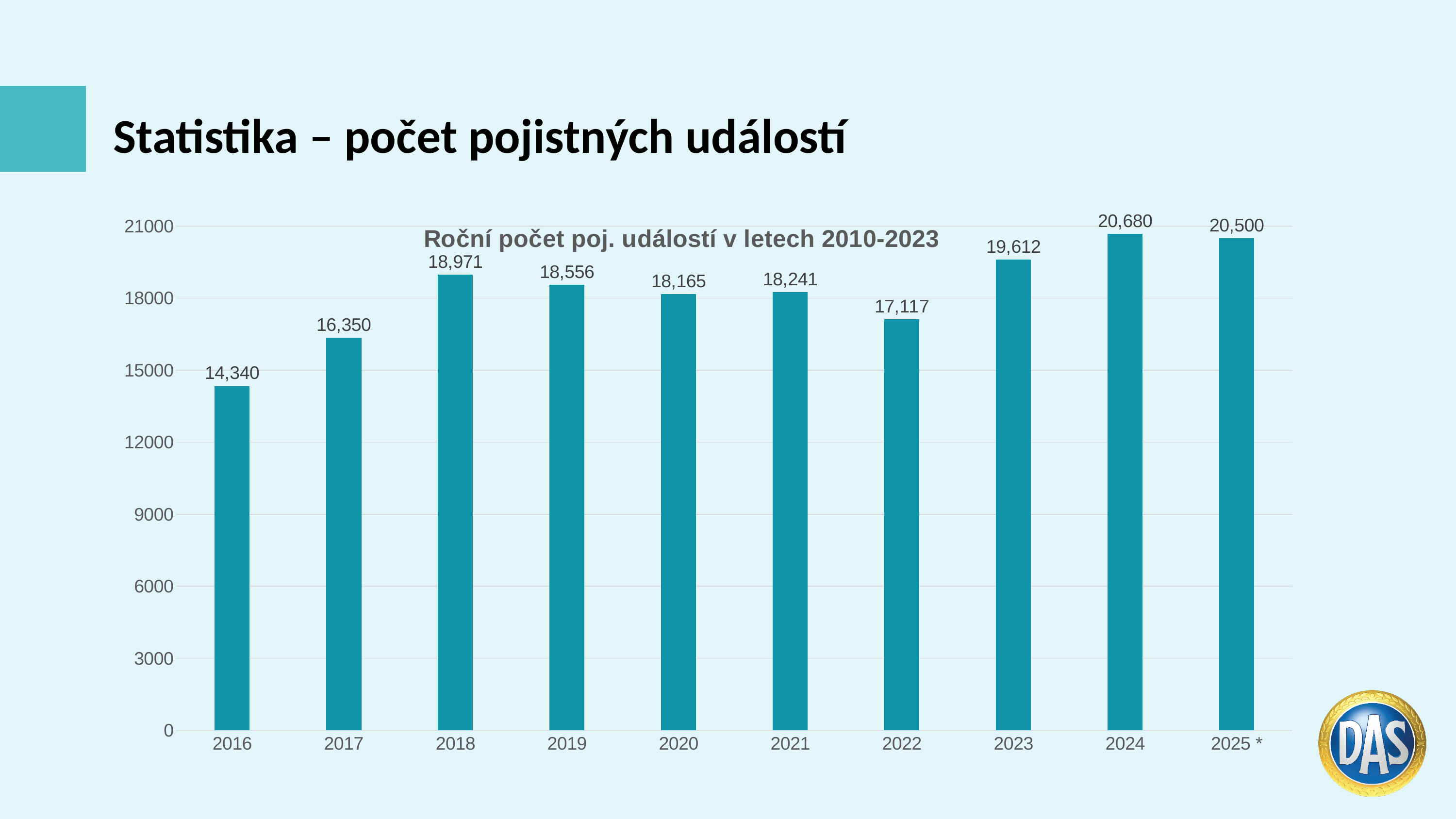
What is the difference between the values for 2024 and 2023? 1,068 What is the title of the chart? Roční počet poj. událostí v letech 2010-2023 What kind of chart is shown? bar chart Is the value for 2017 greater or less than 18000? less Do the values rise or fall from 2021 to 2022? fall What is the value for 2022? 17,117 Which year has the highest value? 2024 What is the value for 2025 *? 20,500 How many years are shown on the x axis? 10 Which is larger, the value for 2018 or the value for 2019? 2018 What is the value for 2016? 14,340 Which year has the lowest value? 2016